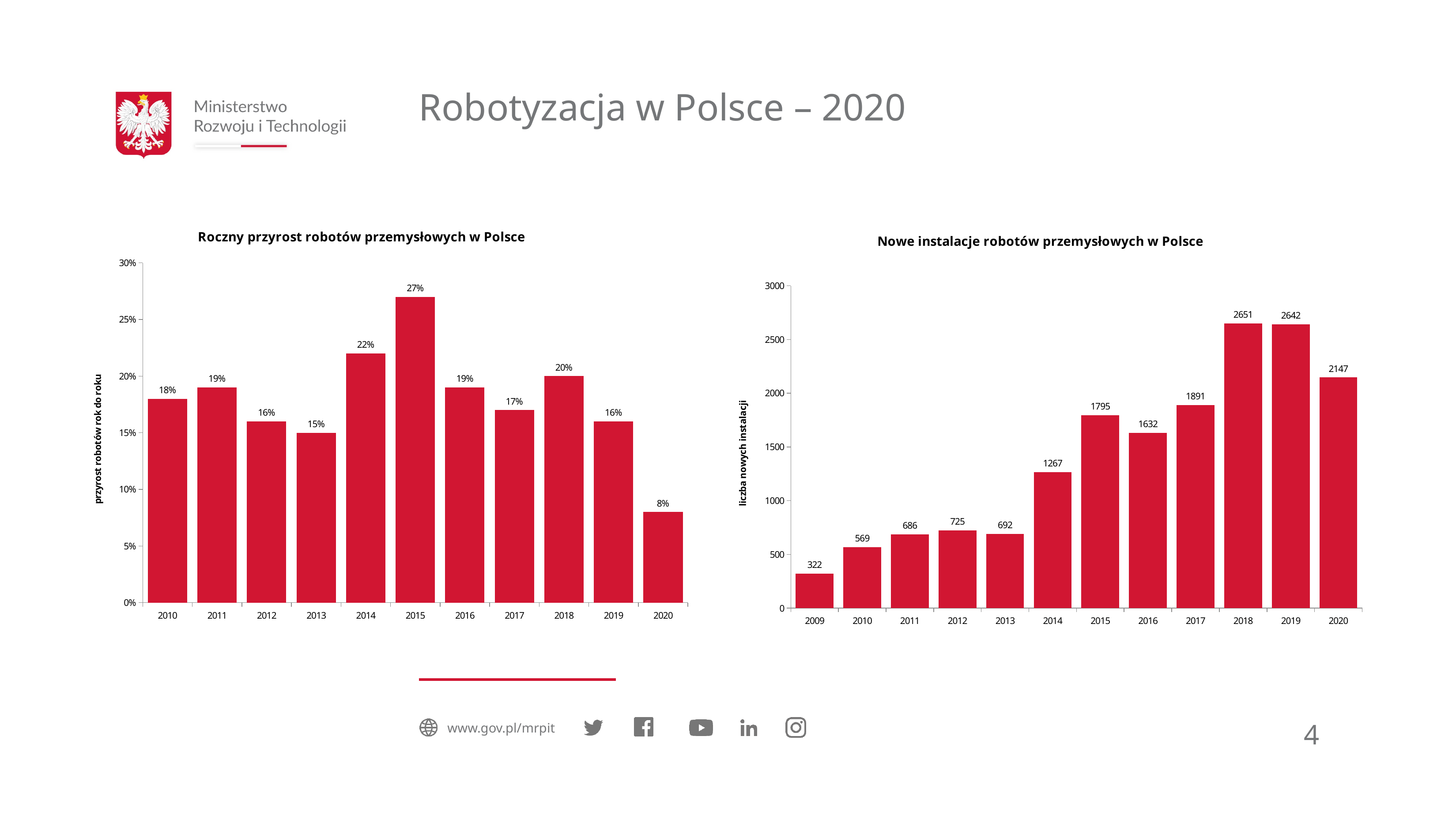
What kind of chart is 'Nowe instalacje robotów przemysłowych w Polsce'? Bar chart In the chart 'Nowe instalacje robotów przemysłowych w Polsce', what is the value for 2009? 322 In the chart 'Nowe instalacje robotów przemysłowych w Polsce', what is the difference between the values for 2019 and 2020? 495 In the chart 'Nowe instalacje robotów przemysłowych w Polsce', how many years are shown on the x axis? 12 In the chart 'Nowe instalacje robotów przemysłowych w Polsce', what is the value for 2018? 2651 In the chart 'Roczny przyrost robotów przemysłowych w Polsce', which year has the lowest value? 2020 In the chart 'Roczny przyrost robotów przemysłowych w Polsce', how many years are shown on the x axis? 11 In the chart 'Roczny przyrost robotów przemysłowych w Polsce', what is the difference between the values for 2014 and 2013? 7% In the chart 'Nowe instalacje robotów przemysłowych w Polsce', which is larger, the value for 2016 or the value for 2017? 2017 In the chart 'Roczny przyrost robotów przemysłowych w Polsce', which year has the highest value? 2015 In the chart 'Roczny przyrost robotów przemysłowych w Polsce', what is the value for 2015? 27% In the chart 'Nowe instalacje robotów przemysłowych w Polsce', which year has the lowest value? 2009